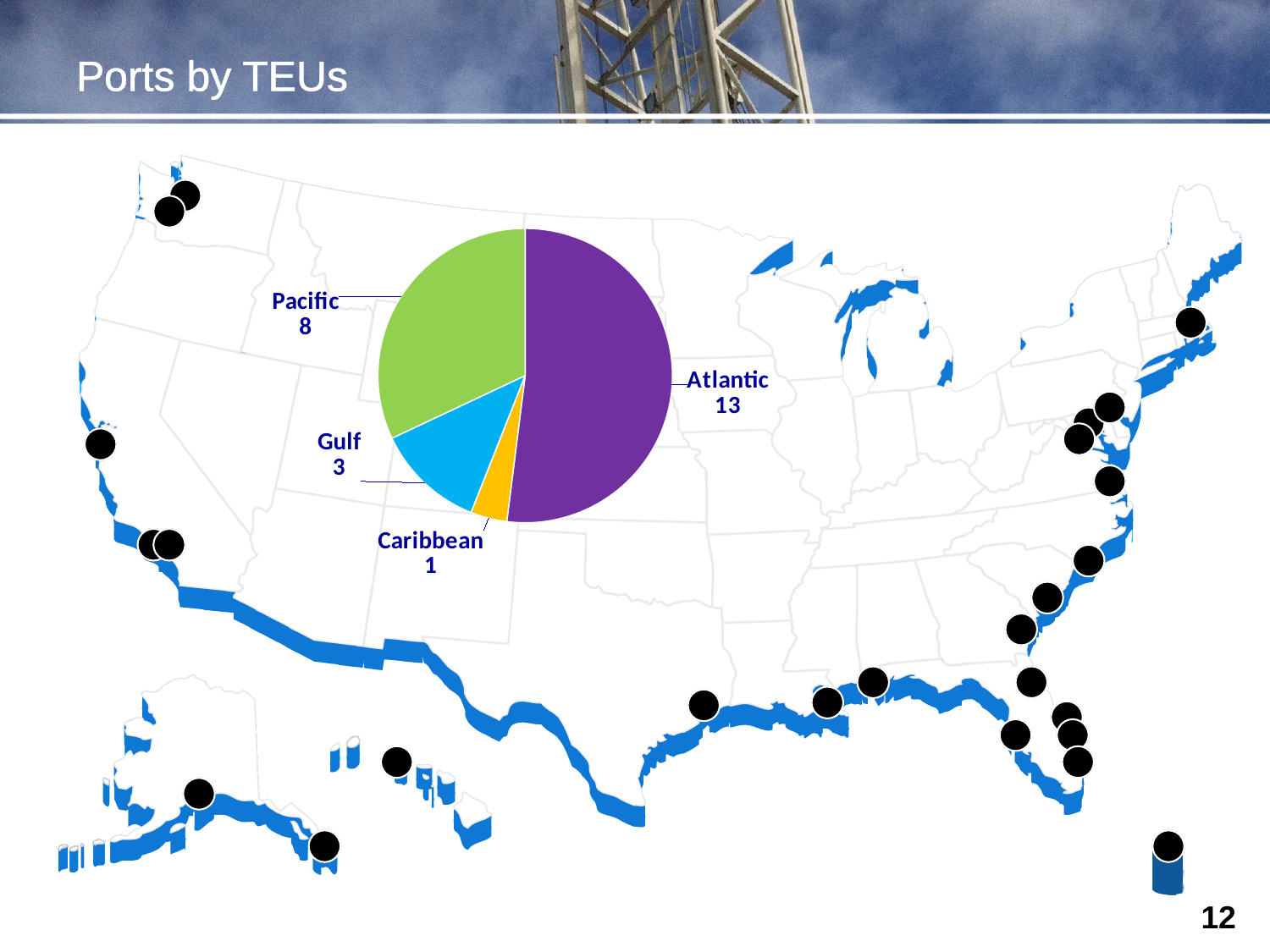
What kind of chart is shown on the slide? pie chart What is the value for Atlantic in the pie chart? 13 What is the value for Pacific in the pie chart? 8 Which slice of the pie chart has the highest value? Atlantic How many slices does the pie chart have? 4 Which is larger in the pie chart, Gulf or Caribbean? Gulf What is the total of all slices in the pie chart? 25 What is the difference between the Atlantic and Pacific values in the pie chart? 5 Which slice of the pie chart has the lowest value? Caribbean What is the value for Caribbean in the pie chart? 1 What share of the pie chart does the Atlantic slice represent? 52% What is the value for Gulf in the pie chart? 3